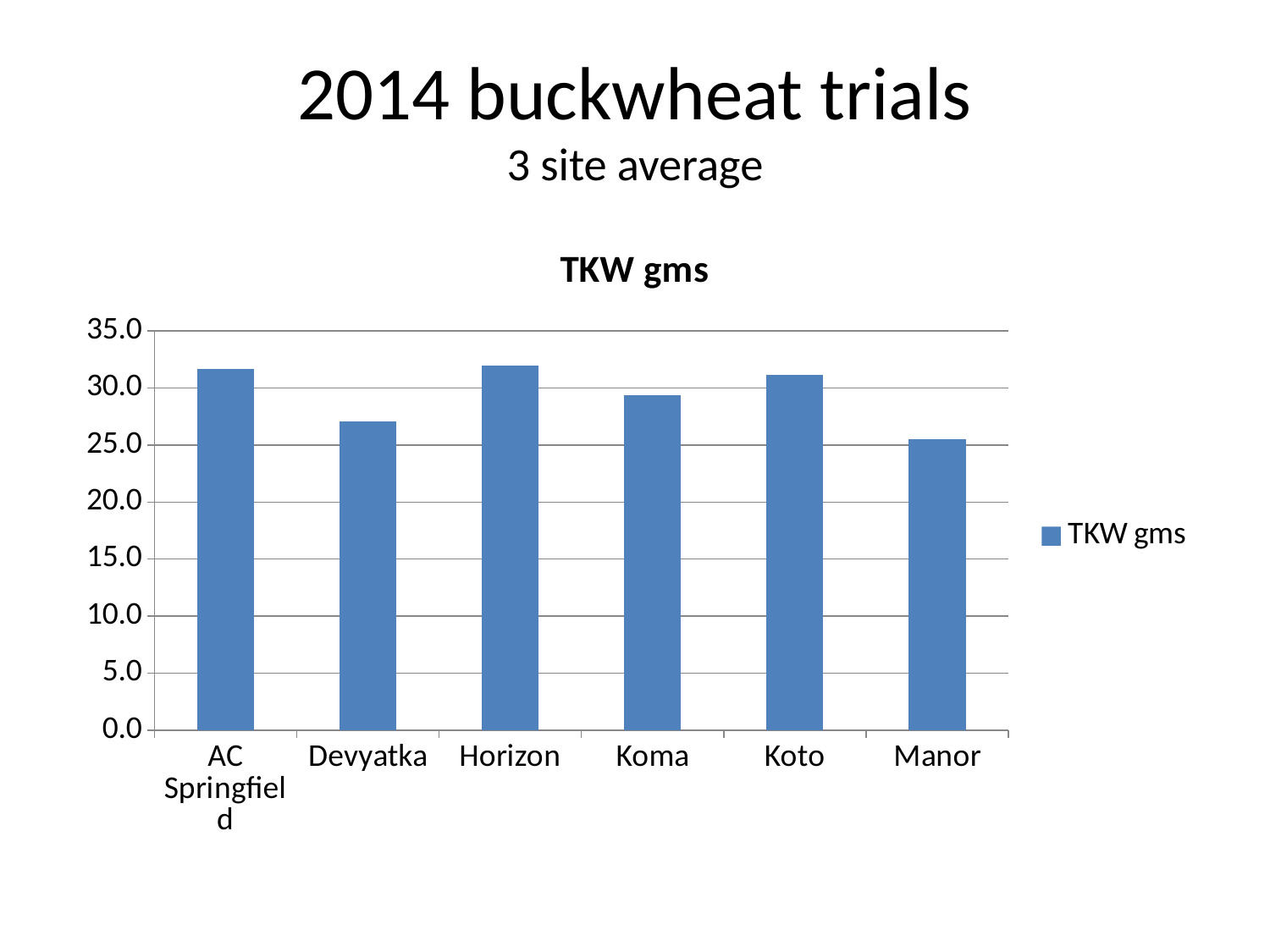
How many varieties are plotted on the chart? 6 Is the value for Horizon greater or less than 30? greater Which has the larger TKW value, Devyatka or Koma? Koma Is the value for Devyatka greater or less than 25? greater What kind of chart is shown on the slide? bar chart Is the value for Manor greater or less than 30? less What is the name of the series shown in the legend? TKW gms How many series does the legend list? 1 Which variety has the lowest TKW value? Manor What is the title of the chart? TKW gms Which has the larger TKW value, Manor or Devyatka? Devyatka